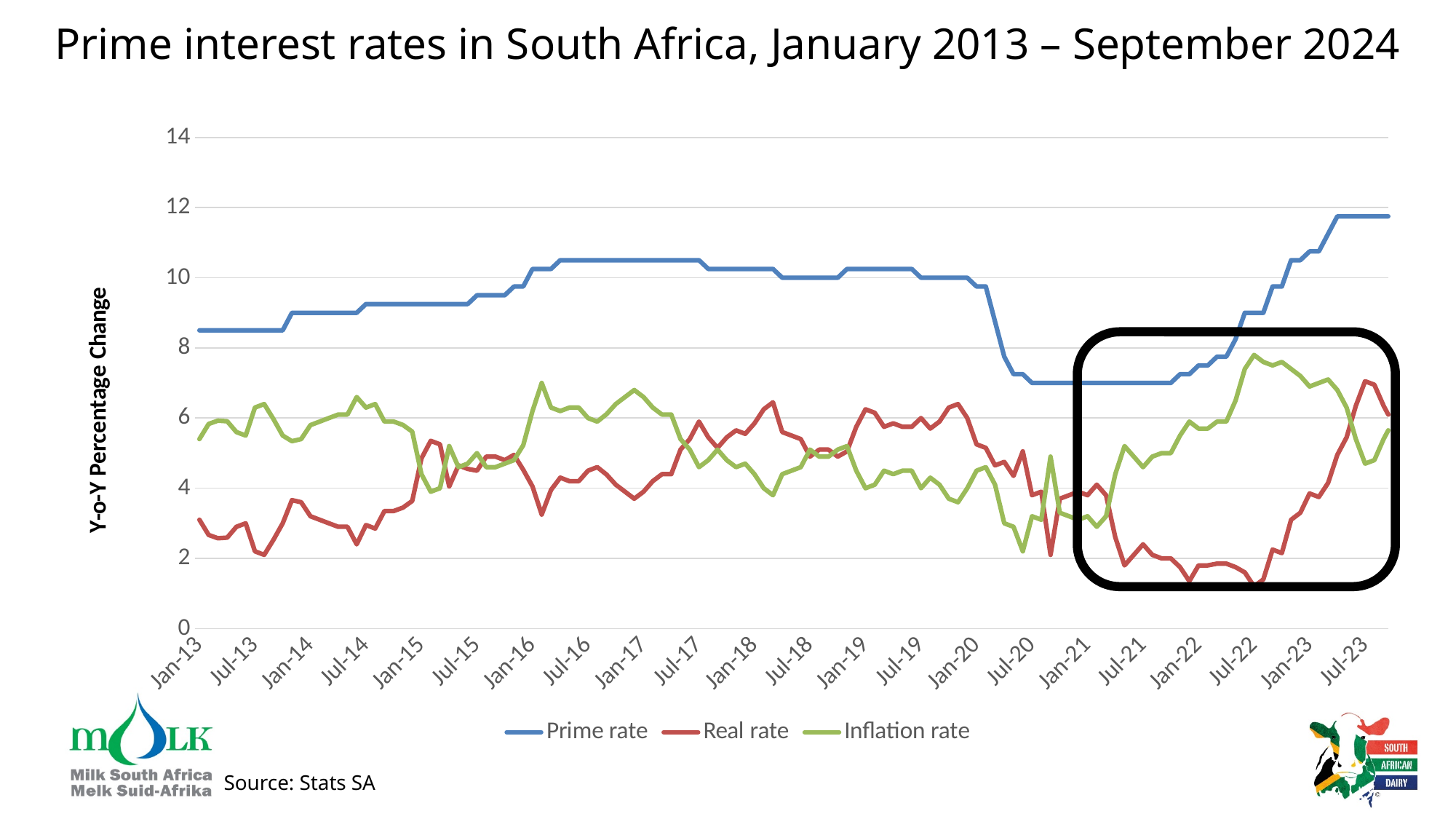
Is the Prime rate at Jul-23 greater or less than 10? greater Does the Real rate rise or fall between Jan-20 and Jan-22? Fall Is the Real rate at Jan-22 greater or less than 4? less What is the label on the vertical axis? Y-o-Y Percentage Change Is the Prime rate at Jan-13 greater or less than 8? greater Does the Prime rate rise or fall between Jan-21 and Jul-23? Rise Which series reaches the highest value on the chart? Prime rate How many series does the legend list? 3 At Jan-22, which is higher: the Real rate or the Inflation rate? Inflation rate What kind of chart is shown on the slide? Line chart What is the title of the chart? Prime interest rates in South Africa, January 2013 – September 2024